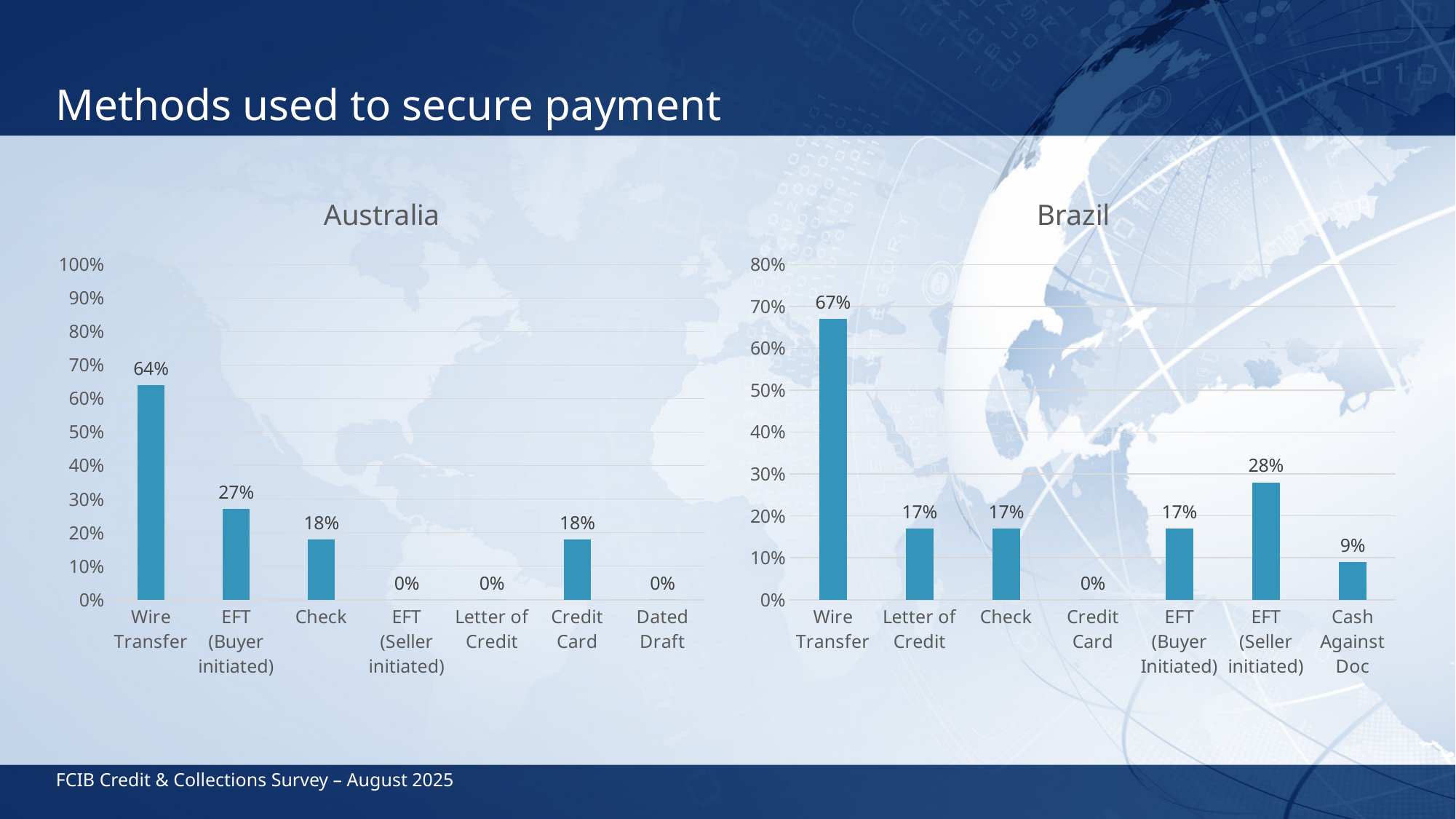
In the Australia chart, what is the value for Wire Transfer? 64% In the Australia chart, which category has the highest value? Wire Transfer In the Brazil chart, which is larger, Letter of Credit or EFT (Seller initiated)? EFT (Seller initiated) In the Australia chart, what is the value for EFT (Buyer initiated)? 27% What kind of chart is the Brazil chart? Bar chart In the Australia chart, how many categories have a value of 0%? 3 In the Brazil chart, what is the difference between Wire Transfer and EFT (Seller initiated)? 39% In the Brazil chart, which category has the highest value? Wire Transfer How many categories are shown in the Australia chart? 7 In the Australia chart, what is the difference between Wire Transfer and EFT (Buyer initiated)? 37% In the Brazil chart, what is the value for EFT (Seller initiated)? 28% In the Brazil chart, what is the value for Cash Against Doc? 9%